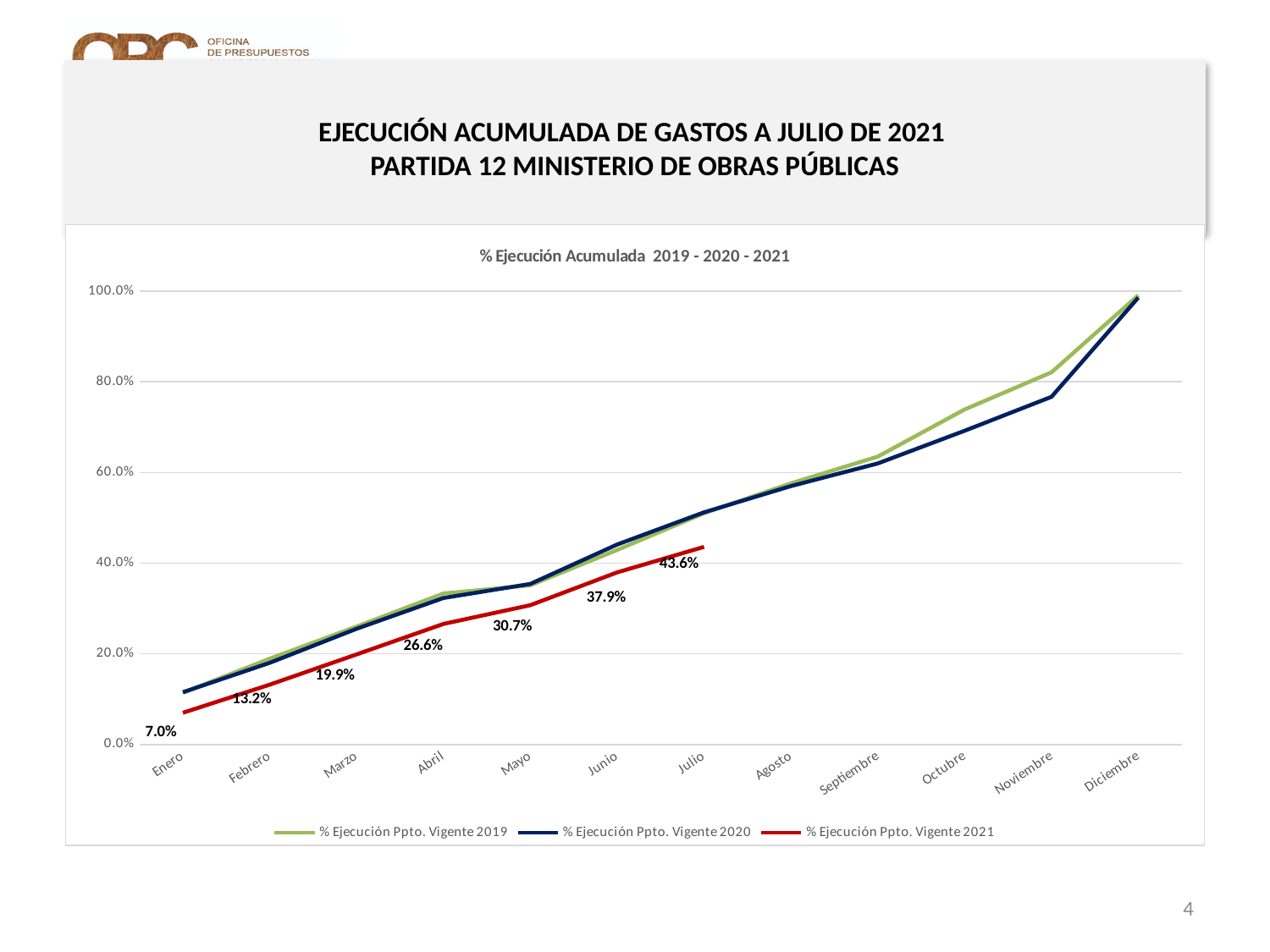
What is the difference between the 2021 values for Marzo and Febrero? 6.7% Does the % Ejecución Ppto. Vigente 2021 series rise or fall from Enero to Julio? rise What is the value of % Ejecución Ppto. Vigente 2021 for Abril? 26.6% What kind of chart is shown on the slide? line chart Which month has the lowest value for the % Ejecución Ppto. Vigente 2021 series? Enero How many months are shown on the x axis of the chart? 12 How many series does the chart legend list? 3 Which month has the highest value for the % Ejecución Ppto. Vigente 2021 series? Julio What is the value of % Ejecución Ppto. Vigente 2021 for Enero? 7.0% What is the value of % Ejecución Ppto. Vigente 2021 for Julio? 43.6% Is the value for % Ejecución Ppto. Vigente 2020 in Noviembre greater or less than 80.0%? less What is the difference between the 2021 values for Julio and Junio? 5.7%